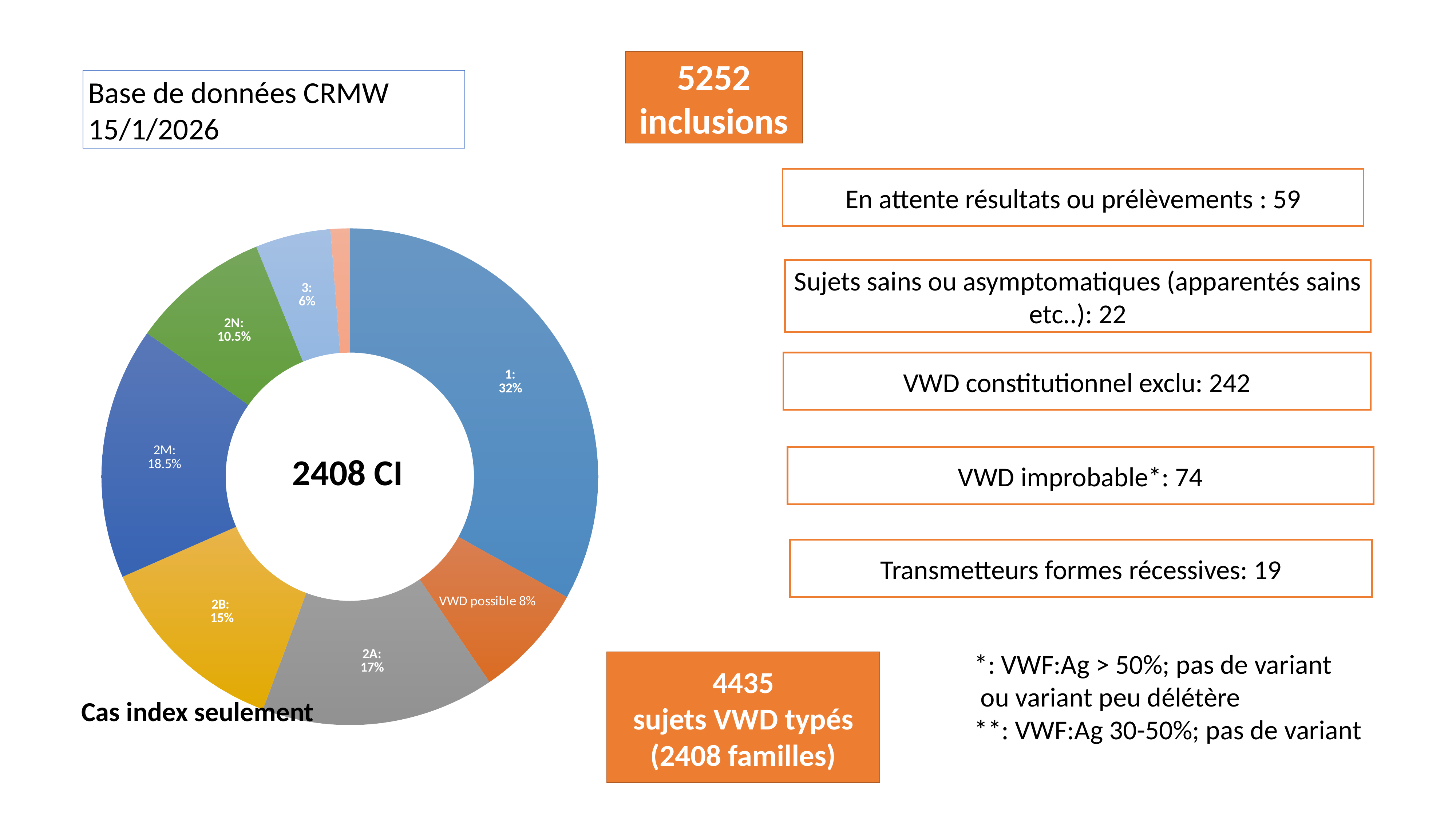
What percentage of the doughnut chart is labelled for type 1? 32% Among the slices with a printed percentage, which has the smallest value? 3 What text is written in the centre of the doughnut chart? 2408 CI What percentage is shown for the 'VWD possible' slice? 8% What is the difference in percentage points between the 2M slice and the 2B slice? 3.5% Which slice is larger, 2N or 3? 2N What kind of chart is shown on the slide? doughnut chart Which slice is larger, 2A or 2B? 2A What percentage is shown for the 2N slice? 10.5% What is the difference in percentage points between the type 1 slice and the 2A slice? 15% What percentage is shown for the 2M slice of the doughnut chart? 18.5% Which slice of the doughnut chart has the largest percentage? 1